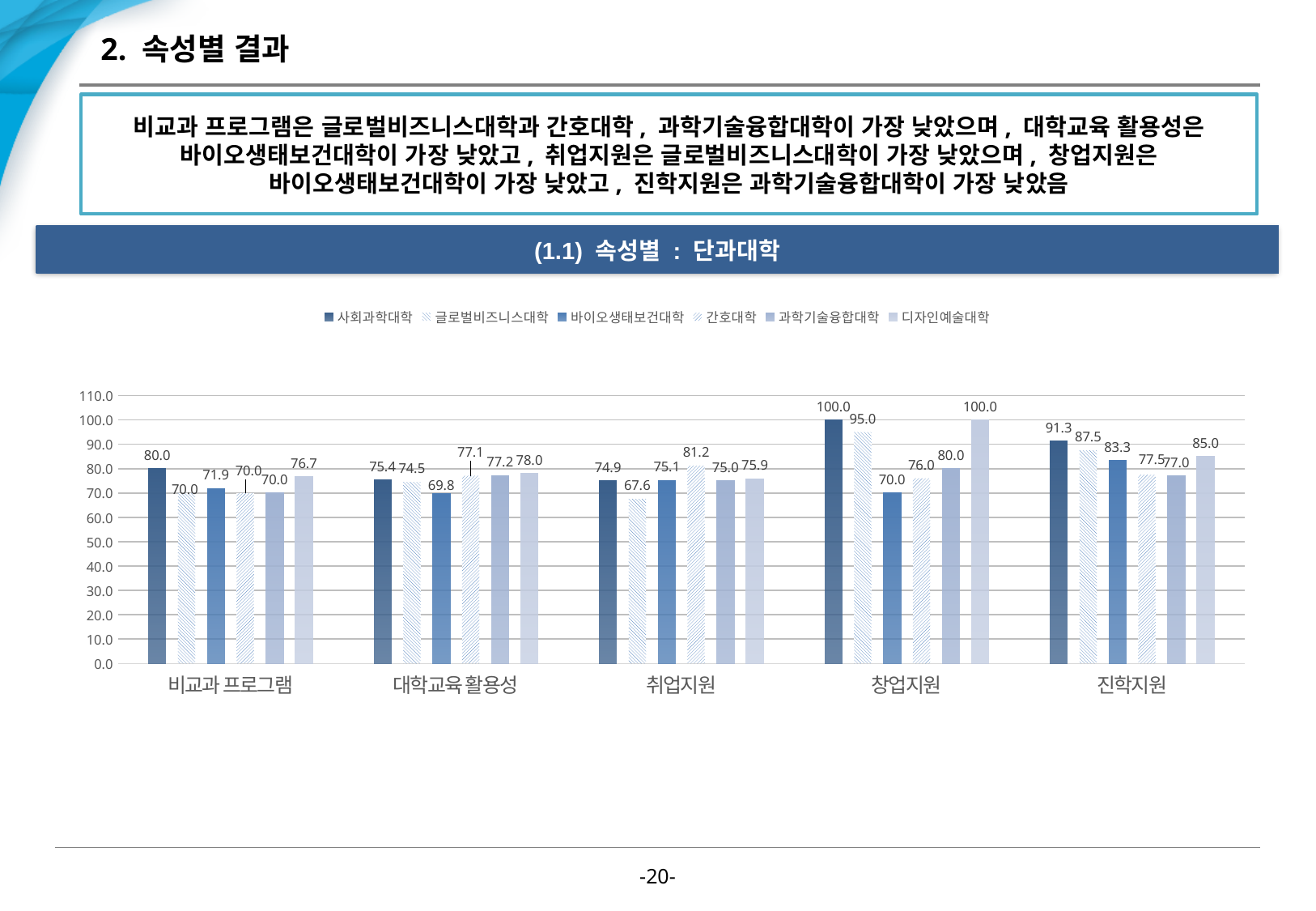
What is the value for 간호대학 in the 취업지원 category? 81.2 What is the value for 사회과학대학 in the 비교과 프로그램 category? 80.0 How many categories are shown on the x axis? 5 What is the value for 바이오생태보건대학 in the 대학교육 활용성 category? 69.8 In the 진학지원 category, which is larger: 글로벌비즈니스대학 or 디자인예술대학? 글로벌비즈니스대학 What type of chart is shown on the slide? bar chart Which college has the highest value in the 진학지원 category? 사회과학대학 What is the difference between 사회과학대학 and 바이오생태보건대학 in the 창업지원 category? 30.0 Which college has the lowest value in the 취업지원 category? 글로벌비즈니스대학 What is the difference between 디자인예술대학 and 글로벌비즈니스대학 in the 비교과 프로그램 category? 6.7 Which college has the lowest value in the 창업지원 category? 바이오생태보건대학 How many series does the legend list? 6